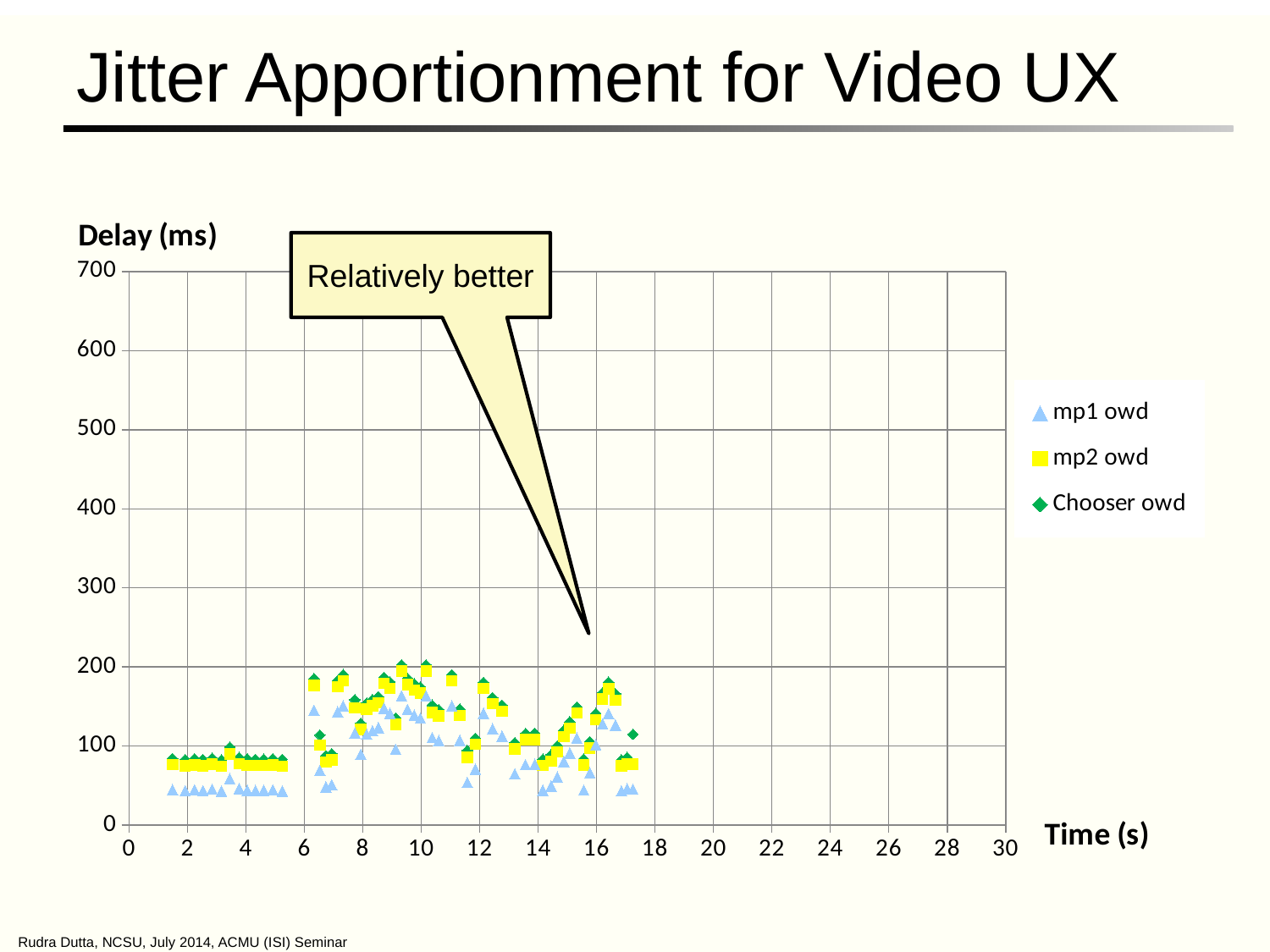
Is the value for mp1 owd at 2 seconds greater or less than 100? less What kind of chart is shown on the slide? scatter chart Do the mp2 owd values rise or fall between about 4 seconds and about 7 seconds? rise What is the maximum value shown on the Time (s) axis? 30 Is the Chooser owd value at about 9 seconds greater or less than 100? greater Which series is plotted with blue triangles? mp1 owd Which series generally has the lowest delay values across the plotted time range? mp1 owd Is the highest Chooser owd value greater or less than 300? less What is the title of the slide containing the chart? Jitter Apportionment for Video UX How many series does the legend list? 3 At about 2 seconds, which series has the larger delay, mp1 owd or mp2 owd? mp2 owd